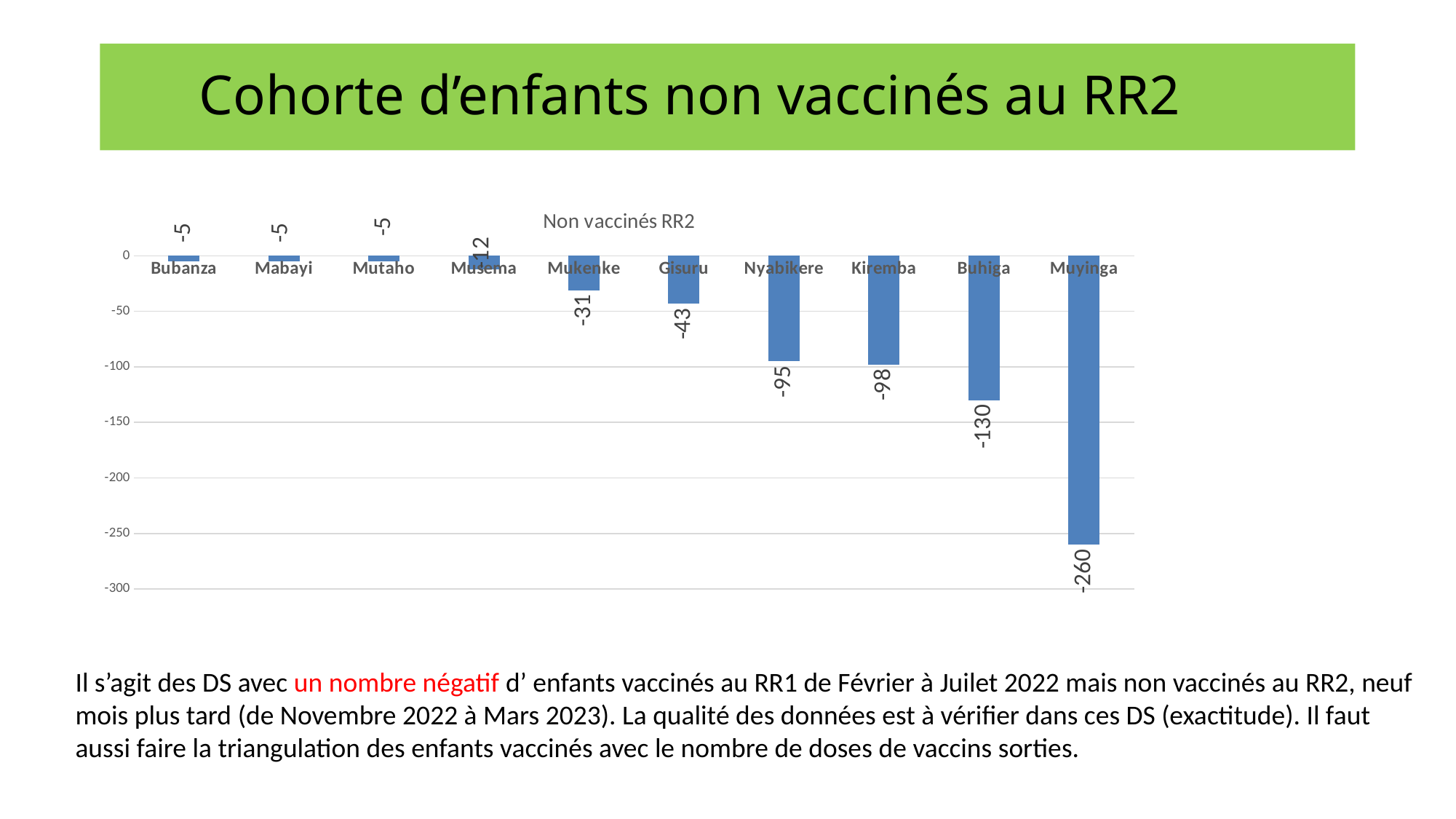
Is the value for Muyinga greater or less than -200? less What kind of chart is shown on the slide? bar chart Do the values rise or fall from left to right along the x axis? fall What is the title of the chart? Non vaccinés RR2 What is the difference between the values for Buhiga and Mukenke? 99 What is the value for Nyabikere? -95 What is the value for Buhiga? -130 What is the value for Muyinga? -260 What is the value for Gisuru? -43 How many categories are shown on the x axis? 10 Which has the more negative value, Kiremba or Gisuru? Kiremba Which category has the lowest (most negative) value? Muyinga